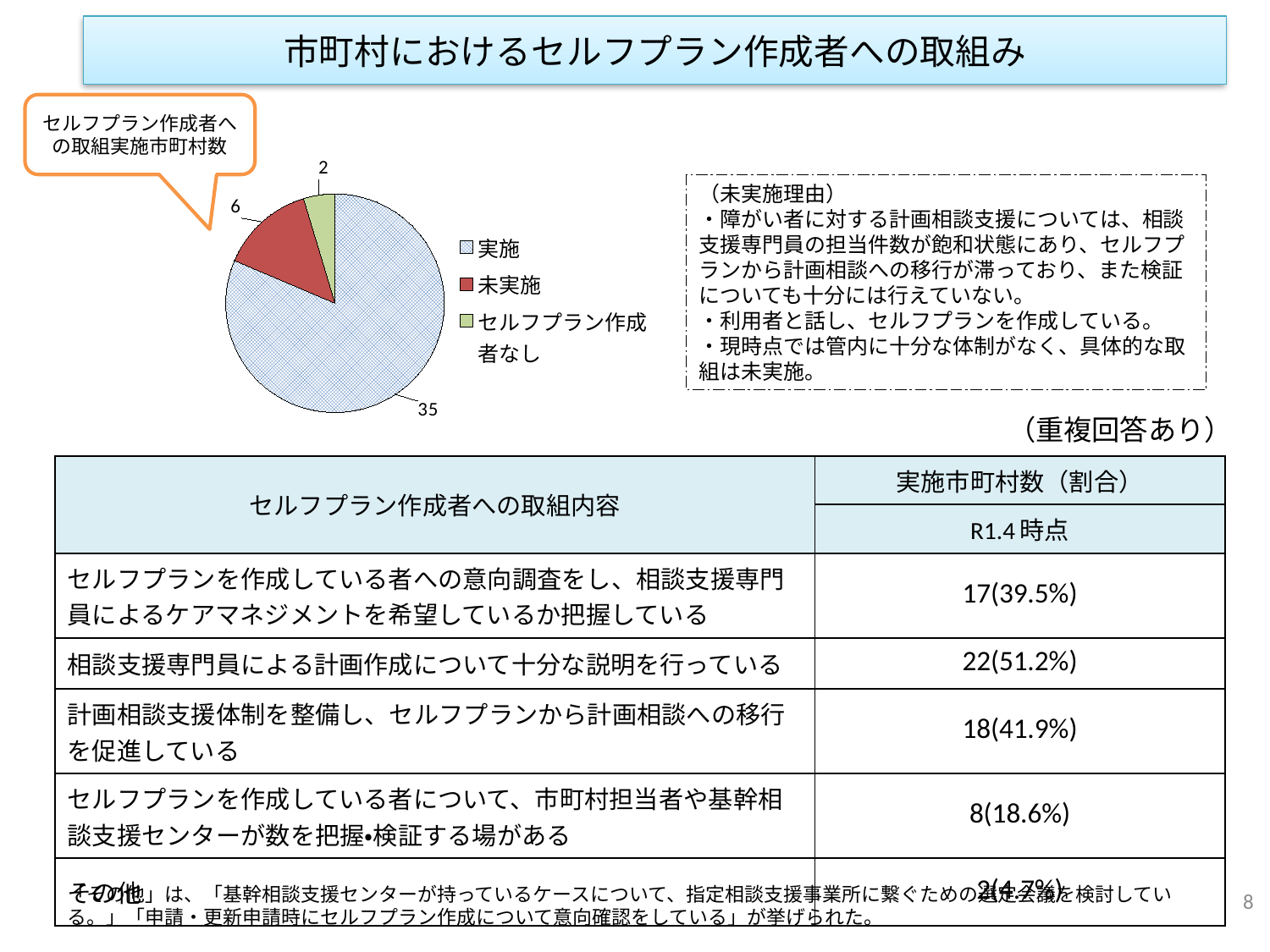
What is the difference between the values for 実施 and 未実施 in the pie chart? 29 How many categories does the pie chart show? 3 What is the value for セルフプラン作成者なし in the pie chart? 2 What is the title shown in the callout above the pie chart? セルフプラン作成者への取組実施市町村数 Which category has the smallest slice in the pie chart? セルフプラン作成者なし What is the value for 未実施 in the pie chart? 6 What is the total of all slices in the pie chart? 43 What is the value for 実施 in the pie chart? 35 What share of the pie chart does 実施 represent? 81.4% Which category has the largest slice in the pie chart? 実施 What type of chart is shown on the slide? pie chart Which is larger in the pie chart, 未実施 or セルフプラン作成者なし? 未実施